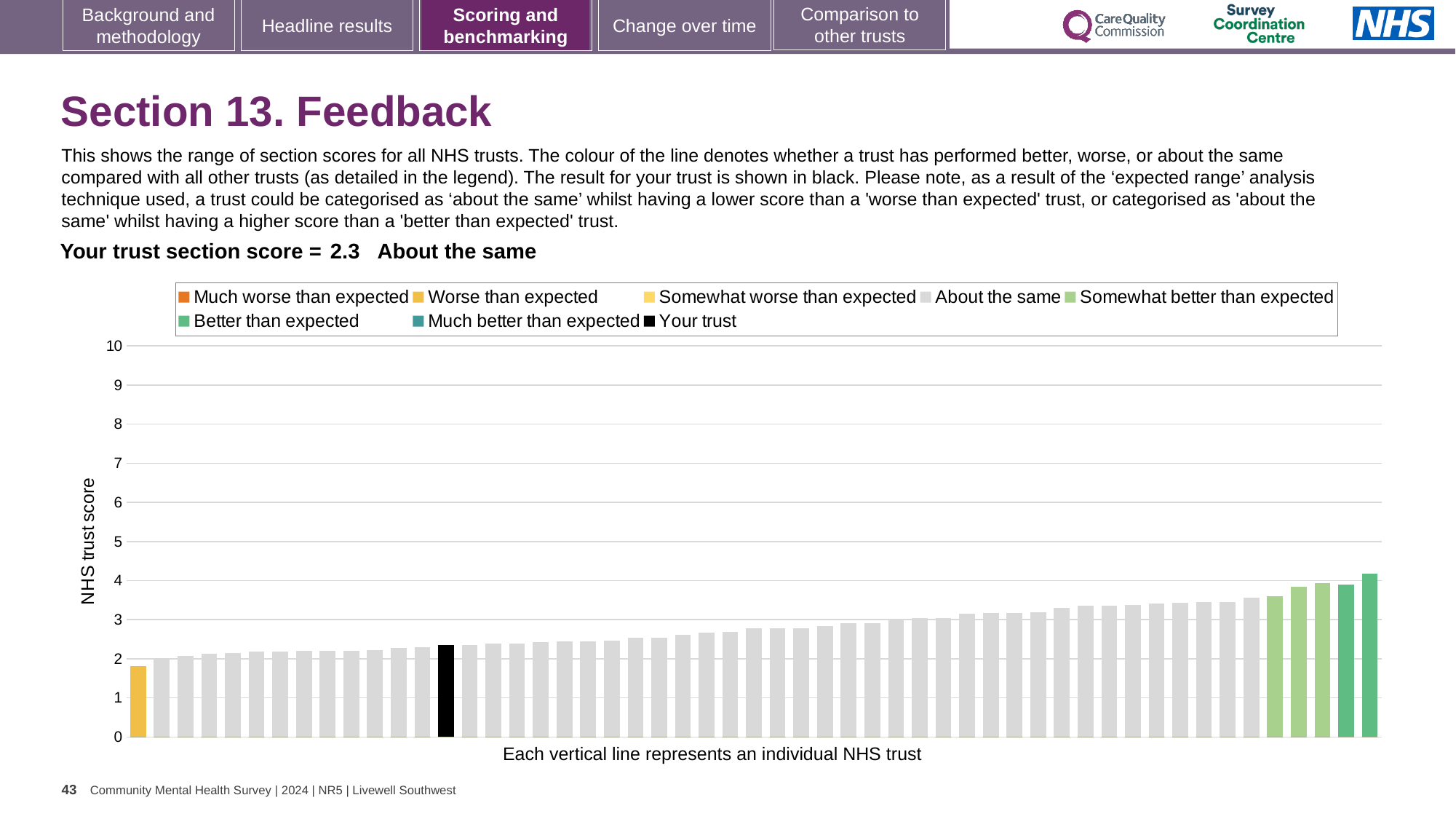
Is the value of the tallest bar in the chart greater or less than 4? greater Do the bar values rise or fall moving from left to right along the x axis? rise What is the label on the y axis of the chart? NHS trust score What is the section score for your trust shown on the slide? 2.3 Is the value of the leftmost (shortest) bar greater or less than 2? less Which legend category does the shortest bar belong to? Worse than expected How many entries does the chart legend list? 8 Which performance category is your trust placed in for Section 13? About the same Is the value of the black bar (your trust) greater or less than 3? less What kind of chart is shown on the slide? bar chart Which legend category does the tallest bar belong to? Better than expected